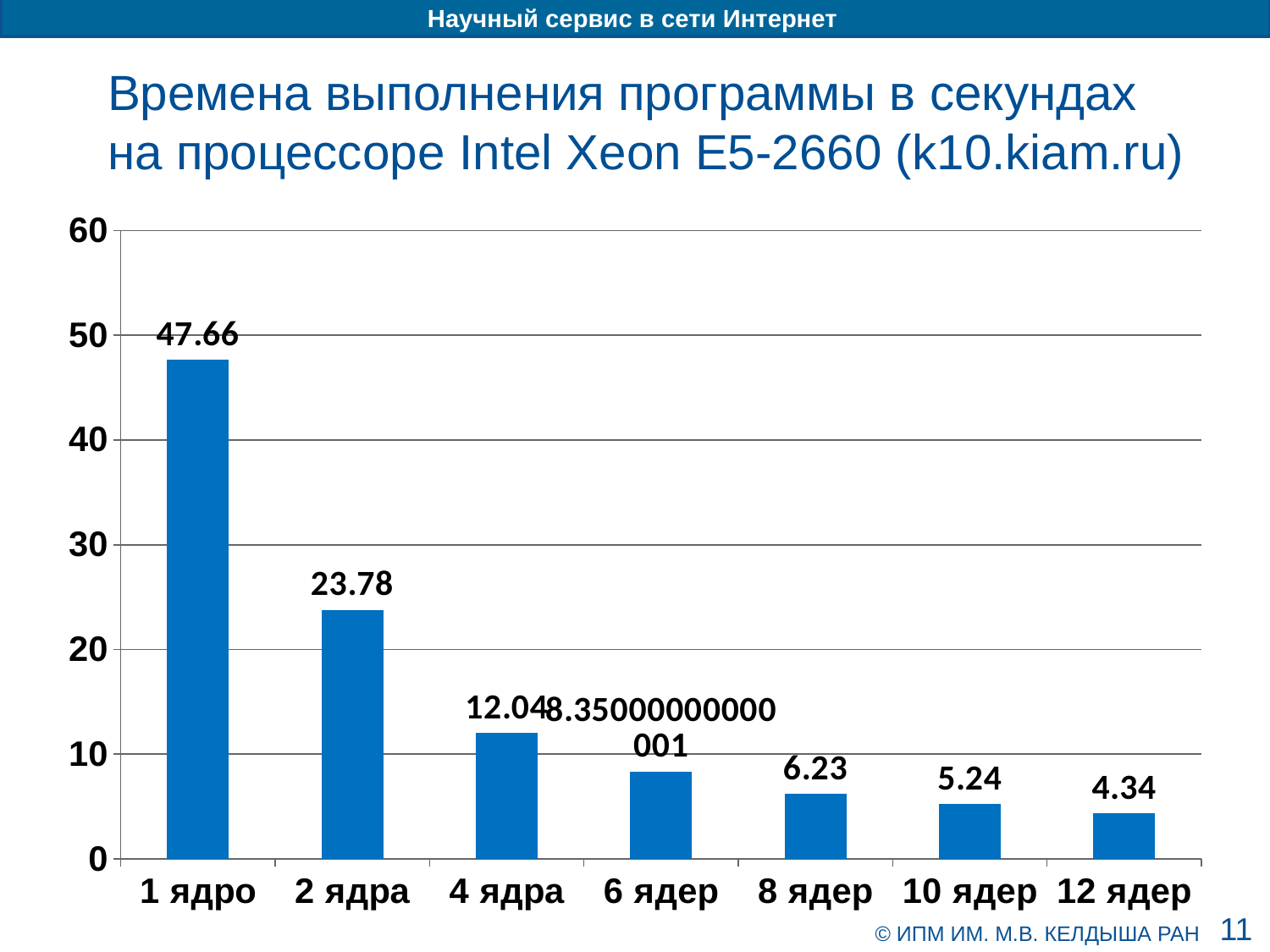
Which category has the highest execution time? 1 ядро What is the value shown for 8 ядер? 6.23 What is the difference between the values for 1 ядро and 2 ядра? 23.88 What is the execution time for 1 ядро? 47.66 What is the execution time for 2 ядра? 23.78 Is the value for 6 ядер greater or less than 10? less What kind of chart is shown on the slide? bar chart Which is larger, the value for 4 ядра or the value for 8 ядер? 4 ядра Which category has the lowest execution time? 12 ядер What is the difference between the values for 10 ядер and 12 ядер? 0.90 What is the value shown for 12 ядер? 4.34 How many categories are shown on the x axis? 7